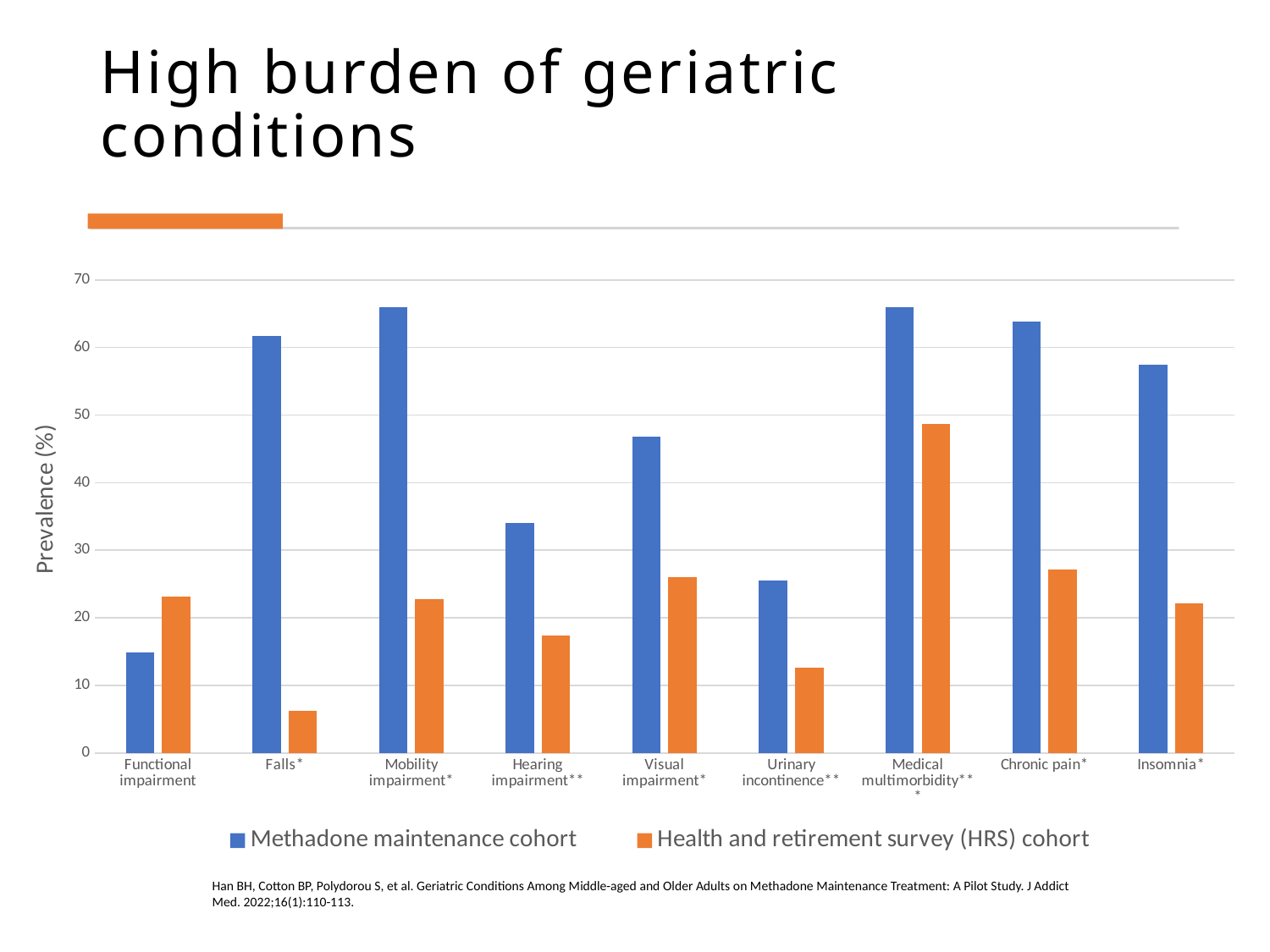
Is the prevalence of Falls* in the Methadone maintenance cohort greater or less than 60? greater What kind of chart is shown on the slide? bar chart Is the prevalence of Insomnia* in the Methadone maintenance cohort greater or less than 50? greater What is the label on the vertical axis of the chart? Prevalence (%) Which condition has the lowest prevalence in the Health and retirement survey (HRS) cohort? Falls* Which condition has the lowest prevalence in the Methadone maintenance cohort? Functional impairment How many series does the legend list? 2 For Functional impairment, which cohort has the higher prevalence? Health and retirement survey (HRS) cohort For Falls*, which cohort has the higher prevalence? Methadone maintenance cohort Is the prevalence of Falls* in the Health and retirement survey (HRS) cohort greater or less than 10? less Which condition has the highest prevalence in the Health and retirement survey (HRS) cohort? Medical multimorbidity*** How many geriatric conditions (categories) are shown on the x axis? 9